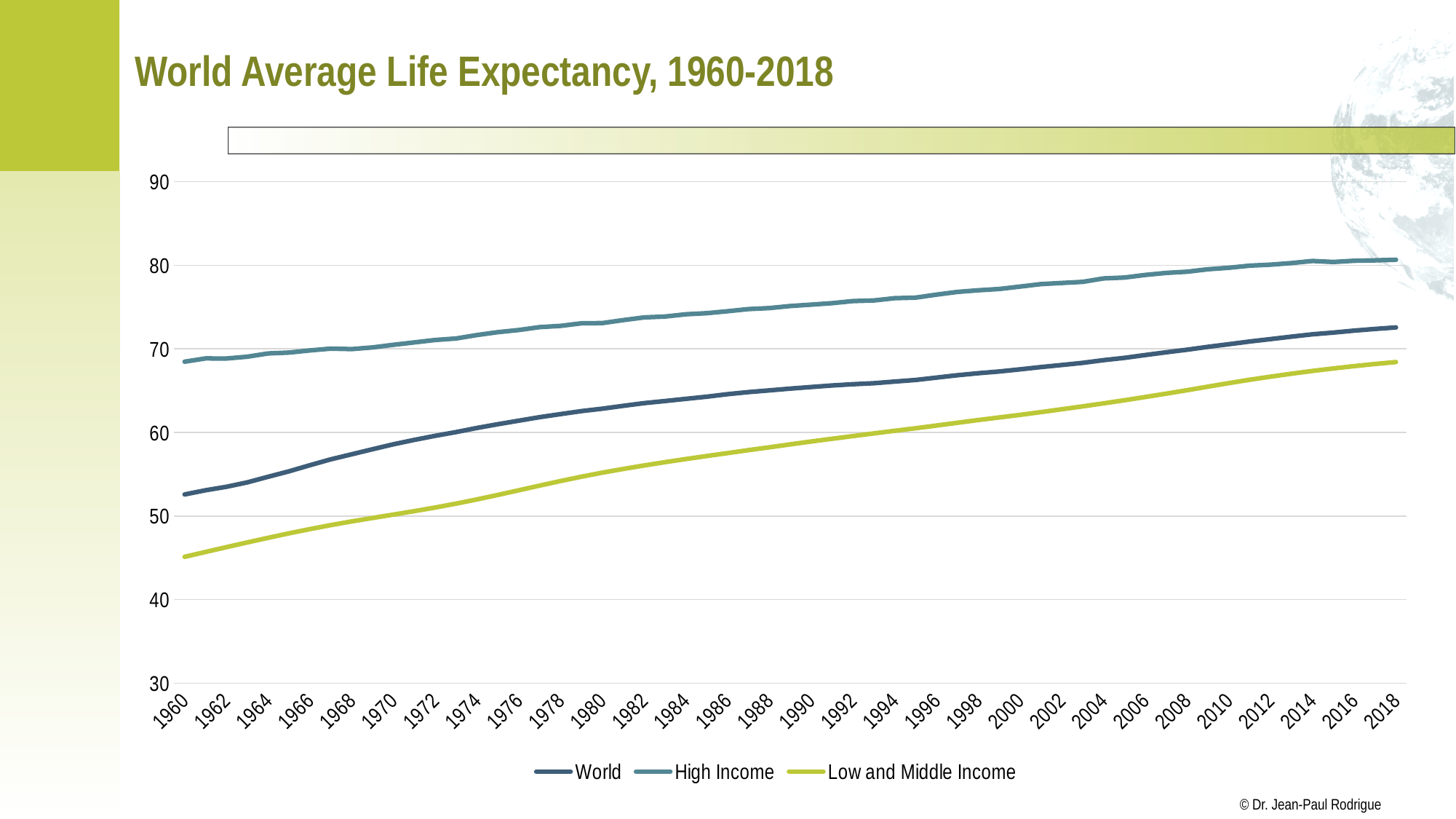
Is the value for World in 1960 greater or less than 50? greater What kind of chart is shown on the slide? line chart In 1990, which is larger: the value for World or the value for Low and Middle Income? World Is the value for High Income in 2018 greater or less than 70? greater Is the value for Low and Middle Income in 1960 greater or less than 50? less Which series has the lowest life expectancy in 1960? Low and Middle Income Does the World life expectancy rise or fall from 1960 to 2018? rise Which series has the highest life expectancy in 2018? High Income Which series is drawn in the yellow-green line? Low and Middle Income What is the title of the chart? World Average Life Expectancy, 1960-2018 How many series does the legend list? 3